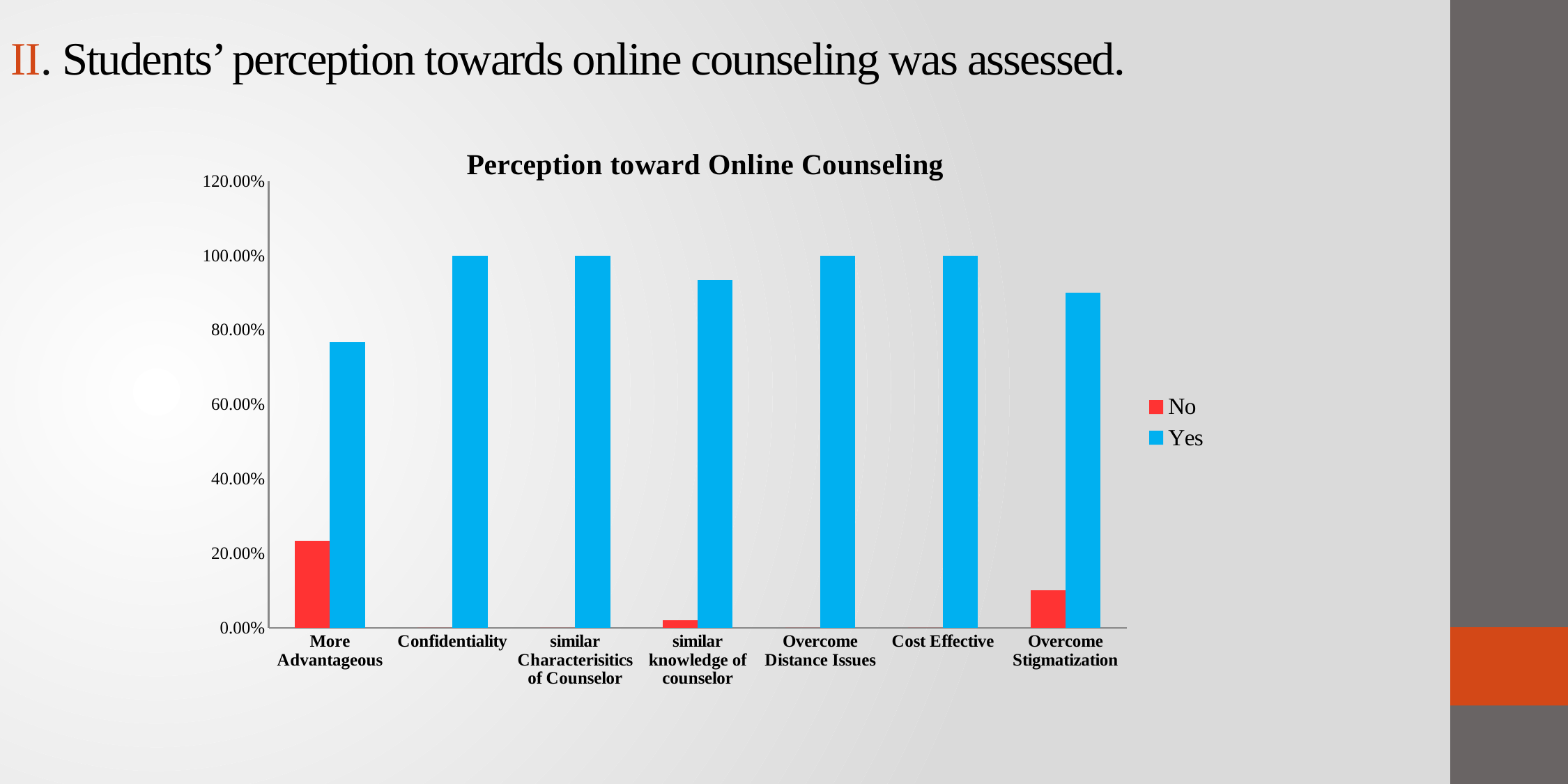
Which category has the lowest Yes value? More Advantageous What is the Yes value for Cost Effective? 100.00% Is the Yes value for Overcome Stigmatization greater or less than 80.00%? greater Which is larger, the No value for More Advantageous or the No value for Overcome Stigmatization? More Advantageous Is the Yes value for More Advantageous greater or less than 80.00%? less What is the title of the chart? Perception toward Online Counseling What kind of chart is shown on the slide? bar chart What is the Yes value for Confidentiality? 100.00% How many categories are shown on the x axis? 7 How many series does the legend list? 2 Is the No value for More Advantageous greater or less than 20.00%? greater What is the Yes value for Overcome Distance Issues? 100.00%